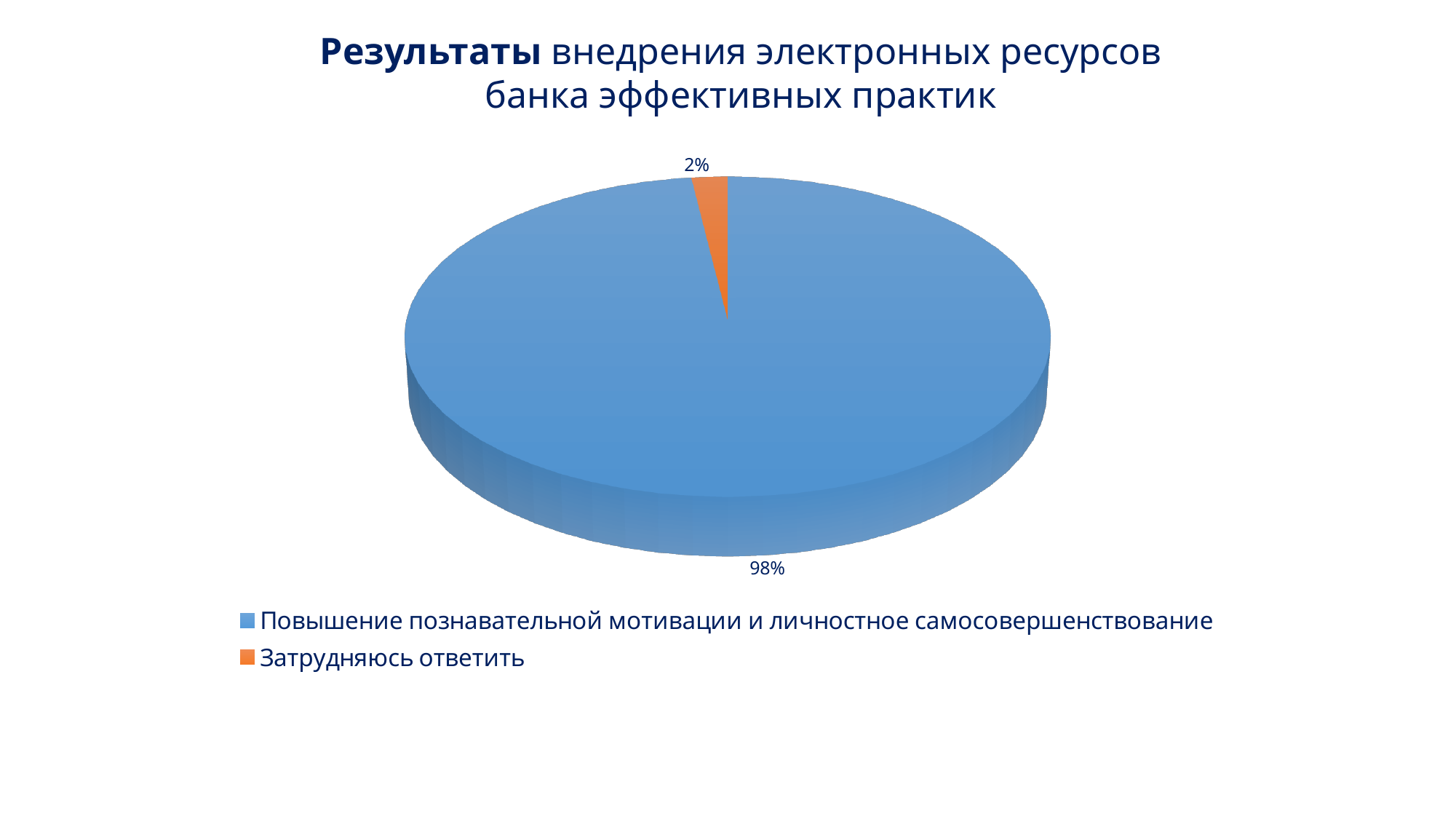
What is the title of the slide? Результаты внедрения электронных ресурсов банка эффективных практик What is the difference in percentage points between the two slices of the pie? 96 What share of the pie does "Повышение познавательной мотивации и личностное самосовершенствование" take? 98% What share of the pie does "Затрудняюсь ответить" take? 2% How many categories does the pie chart have? 2 Which category has the largest slice of the pie? Повышение познавательной мотивации и личностное самосовершенствование How many entries does the legend list? 2 What colour is the slice for "Затрудняюсь ответить"? orange What kind of chart is shown on the slide? pie chart Which category has the smallest slice of the pie? Затрудняюсь ответить Which is larger: the slice for "Затрудняюсь ответить" or the slice for "Повышение познавательной мотивации и личностное самосовершенствование"? Повышение познавательной мотивации и личностное самосовершенствование